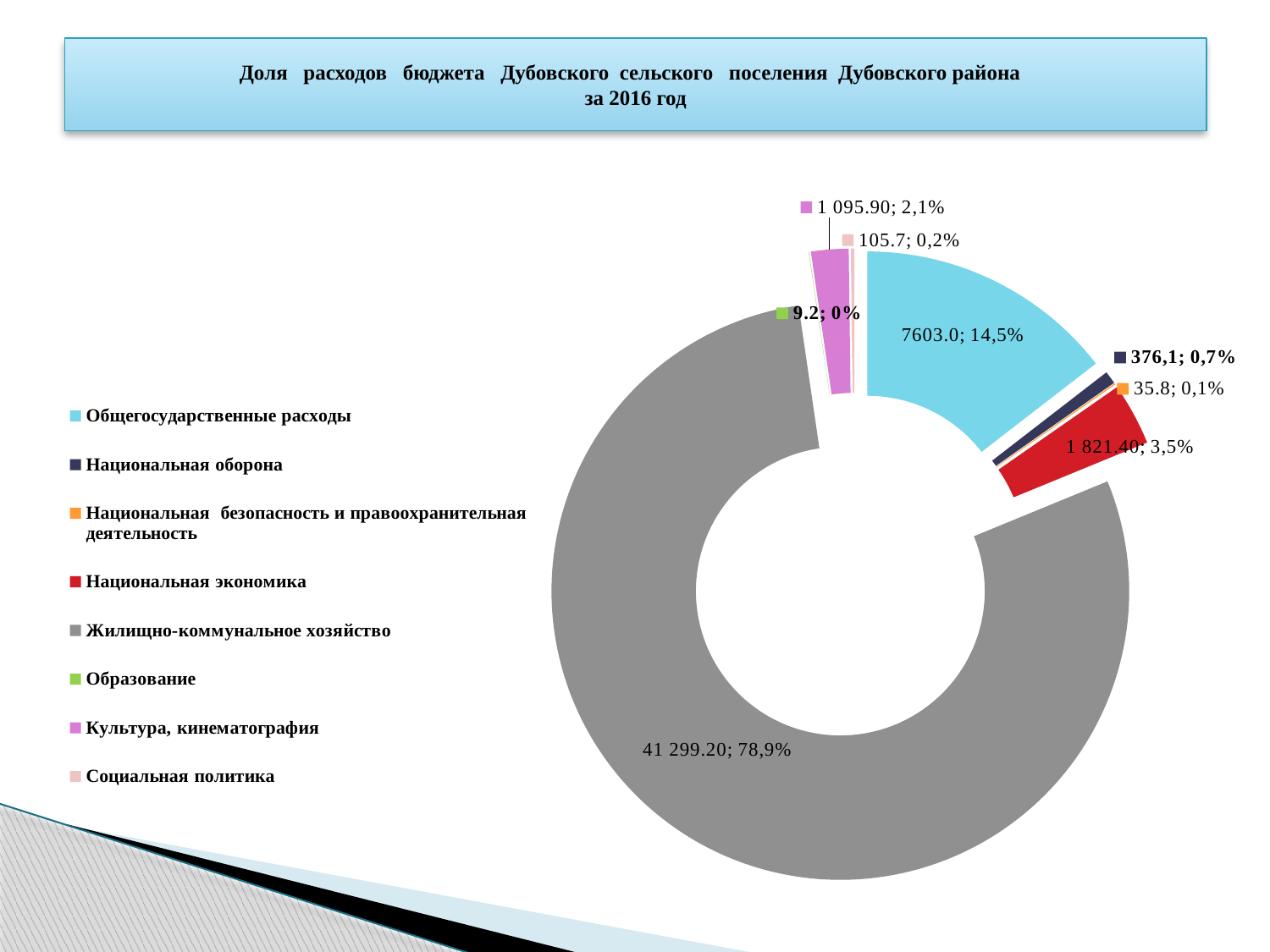
Which is larger, the value for Национальная экономика or the value for Культура, кинематография? Национальная экономика What value is shown for Жилищно-коммунальное хозяйство? 41 299.20 How many categories does the legend list? 8 What colour represents Национальная безопасность и правоохранительная деятельность in the chart? orange What share of the total does Жилищно-коммунальное хозяйство account for? 78,9% What value is shown for Общегосударственные расходы? 7603.0 Which category has the smallest value? Образование What kind of chart is shown on the slide? doughnut chart What value is shown for Культура, кинематография? 1 095.90 What percentage is shown for Национальная оборона? 0,7% What percentage is shown for Национальная экономика? 3,5% Which category has the largest share of the budget expenditures? Жилищно-коммунальное хозяйство